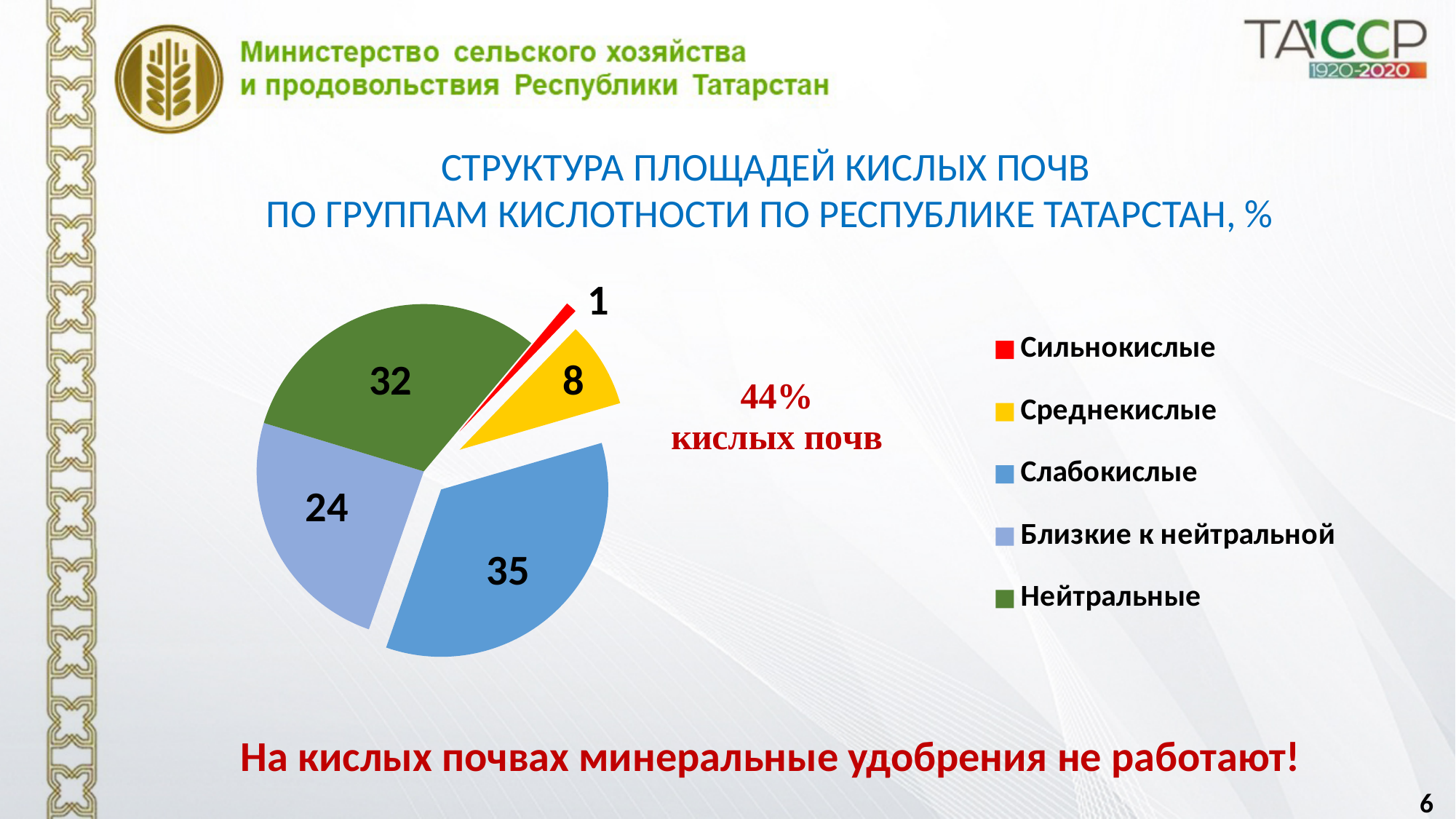
What is the combined value of Сильнокислые, Среднекислые and Слабокислые? 44 What colour is the slice for Среднекислые? yellow What is the difference between the values for Слабокислые and Близкие к нейтральной? 11 How many categories does the legend list? 5 Which category has the smallest slice? Сильнокислые What is the value for Среднекислые? 8 Which category has the largest slice? Слабокислые What is the value for Сильнокислые? 1 What is the value for Нейтральные? 32 What kind of chart is shown on the slide? pie chart What is the value for Слабокислые? 35 Which is larger, Нейтральные or Близкие к нейтральной? Нейтральные